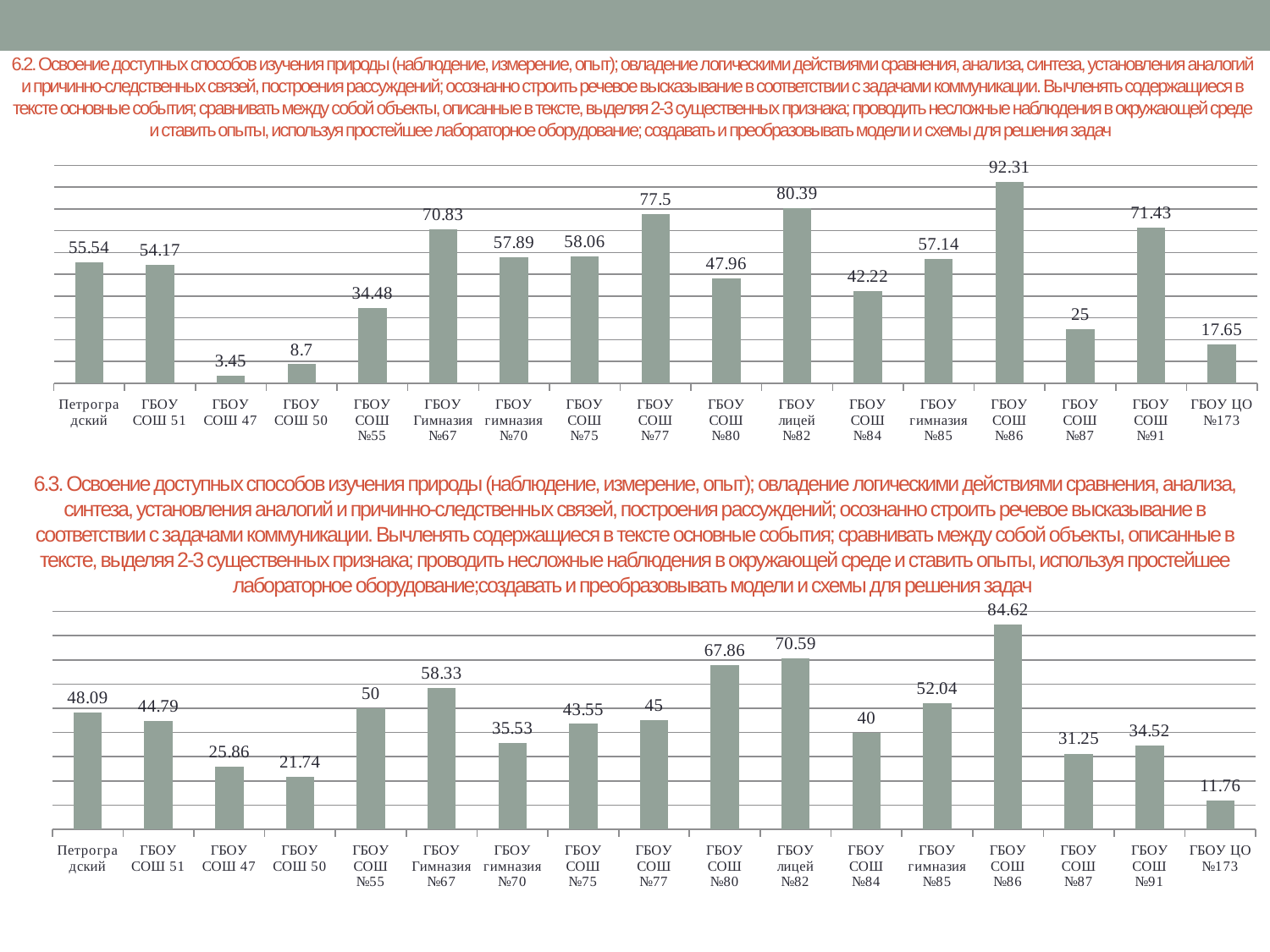
In the top chart (6.2), what is the difference between the values for ГБОУ лицей №82 and ГБОУ СОШ №77? 2.89 In the bottom chart (6.3), which category has the lowest value? ГБОУ ЦО №173 In the top chart (6.2), which is larger: the value for ГБОУ Гимназия №67 or the value for ГБОУ СОШ №91? ГБОУ СОШ №91 In the bottom chart (6.3), what is the difference between the values for ГБОУ лицей №82 and ГБОУ СОШ №80? 2.73 How many categories are shown in the bottom chart (6.3)? 17 In the top chart (6.2), which category has the lowest value? ГБОУ СОШ 47 In the top chart (6.2), what is the value for ГБОУ СОШ 47? 3.45 In the bottom chart (6.3), what is the value for ГБОУ ЦО №173? 11.76 In the top chart (6.2), what is the value for ГБОУ СОШ №86? 92.31 In the bottom chart (6.3), what is the value for Петроградский? 48.09 In the bottom chart (6.3), which category has the highest value? ГБОУ СОШ №86 In the top chart (6.2), which category has the highest value? ГБОУ СОШ №86